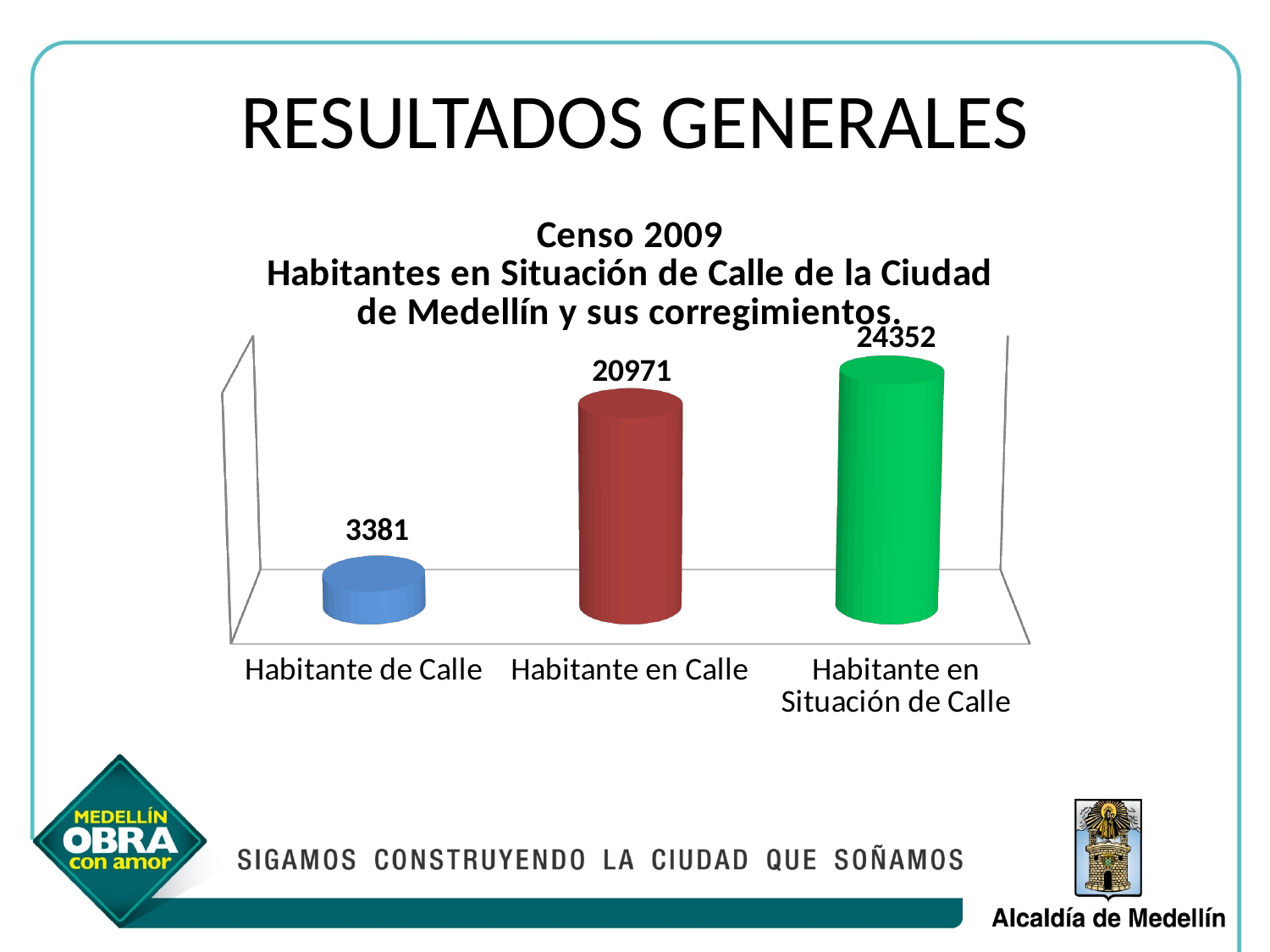
How many categories are shown in the chart? 3 What is the difference between the values for Habitante en Calle and Habitante de Calle? 17590 What is the value for Habitante de Calle? 3381 Which category has the highest value? Habitante en Situación de Calle What is the value for Habitante en Calle? 20971 Do the values rise or fall from left to right across the categories? Rise What colour is the bar for Habitante en Calle? Red What is the value for Habitante en Situación de Calle? 24352 Which category has the lowest value? Habitante de Calle What is the difference between the values for Habitante en Situación de Calle and Habitante en Calle? 3381 Which is larger, the value for Habitante en Calle or the value for Habitante de Calle? Habitante en Calle What kind of chart is shown on the slide? Bar chart